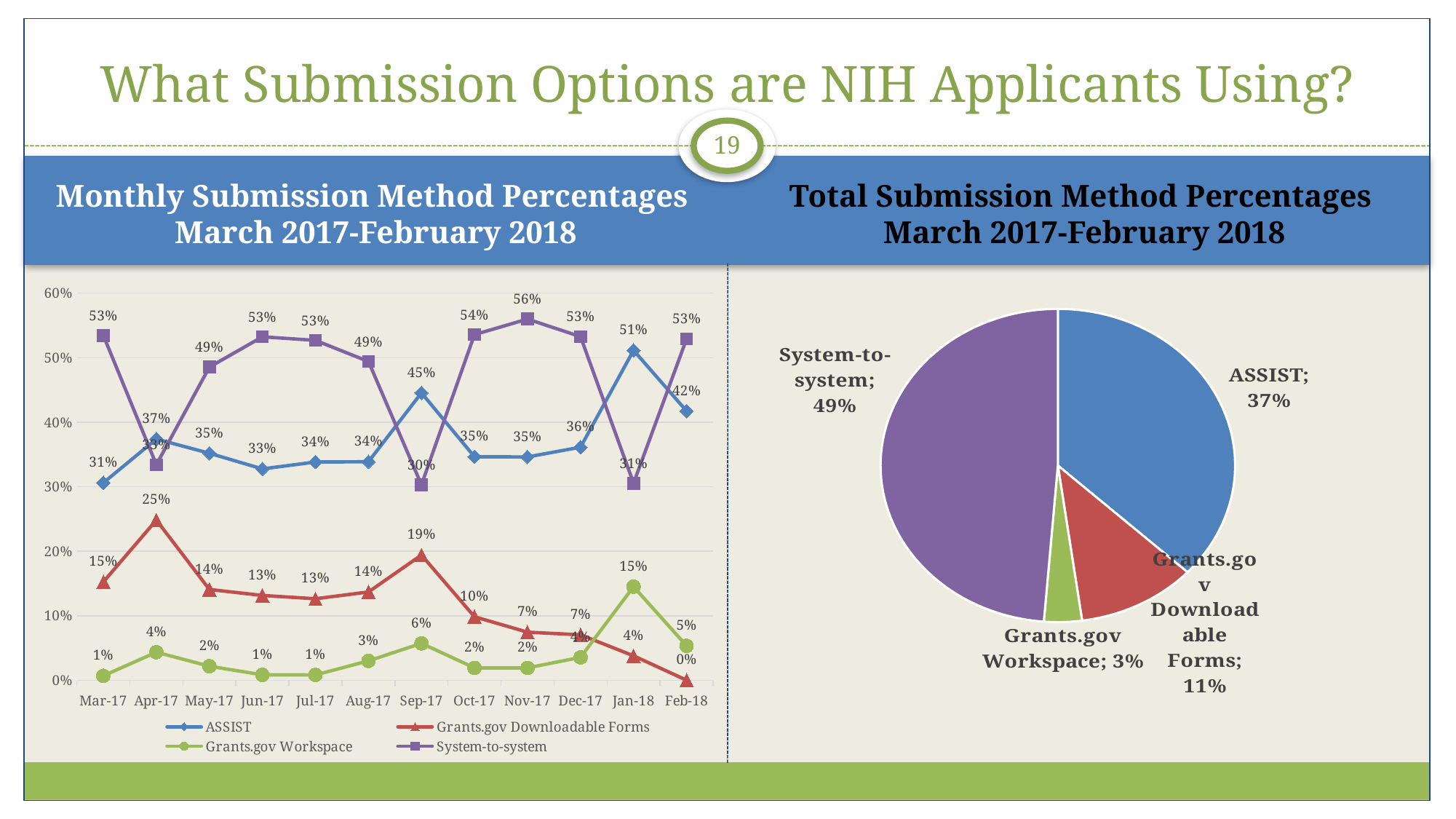
In the Total Submission Method Percentages pie chart, which submission method has the smallest slice? Grants.gov Workspace In the Monthly Submission Method Percentages chart, in which month does Grants.gov Workspace reach its highest value? Jan-18 In the Monthly Submission Method Percentages chart, what is the value for Grants.gov Downloadable Forms in Apr-17? 25% In the Monthly Submission Method Percentages chart, which is larger in Sep-17: ASSIST or System-to-system? ASSIST In the Monthly Submission Method Percentages chart, what is the value for ASSIST in Jan-18? 51% In the Monthly Submission Method Percentages chart, what is the value for System-to-system in Nov-17? 56% In the Total Submission Method Percentages pie chart, what share does System-to-system have? 49% What kind of chart is the Total Submission Method Percentages chart on the right? Pie chart How many months are shown on the x axis of the Monthly Submission Method Percentages chart? 12 In the Monthly Submission Method Percentages chart, in which month is Grants.gov Downloadable Forms at its lowest value? Feb-18 In the Monthly Submission Method Percentages chart, what is the difference between System-to-system and ASSIST in Mar-17? 22% How many series does the legend of the Monthly Submission Method Percentages chart list? 4